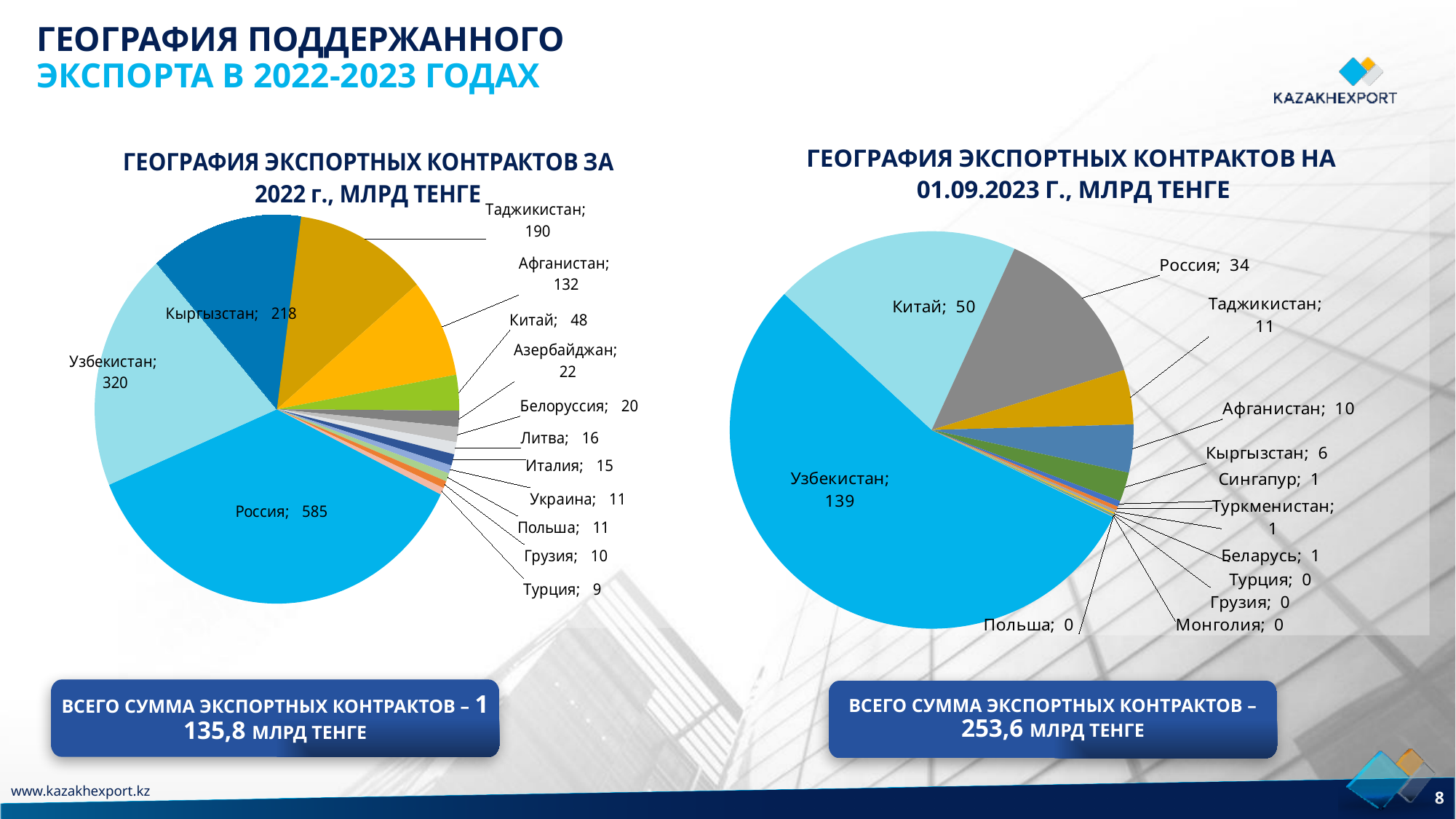
In the left pie chart (2022), what is the value for Россия? 585 How many countries are shown in the left pie chart (2022)? 14 What type of chart is used on the right side of the slide (01.09.2023)? Pie chart In the right pie chart (01.09.2023), what is the difference between the values for Узбекистан and Китай? 89 In the right pie chart (01.09.2023), what is the value for Таджикистан? 11 In the left pie chart (2022), which is larger: the value for Таджикистан or the value for Афганистан? Таджикистан In the right pie chart (01.09.2023), what is the value for Китай? 50 In the right pie chart (01.09.2023), which country has the largest value? Узбекистан In the left pie chart (2022), which country has the largest value? Россия In the left pie chart (2022), what is the difference between the values for Россия and Узбекистан? 265 In the left pie chart (2022), what is the value for Кыргызстан? 218 In the left pie chart (2022), which country has the smallest value? Турция